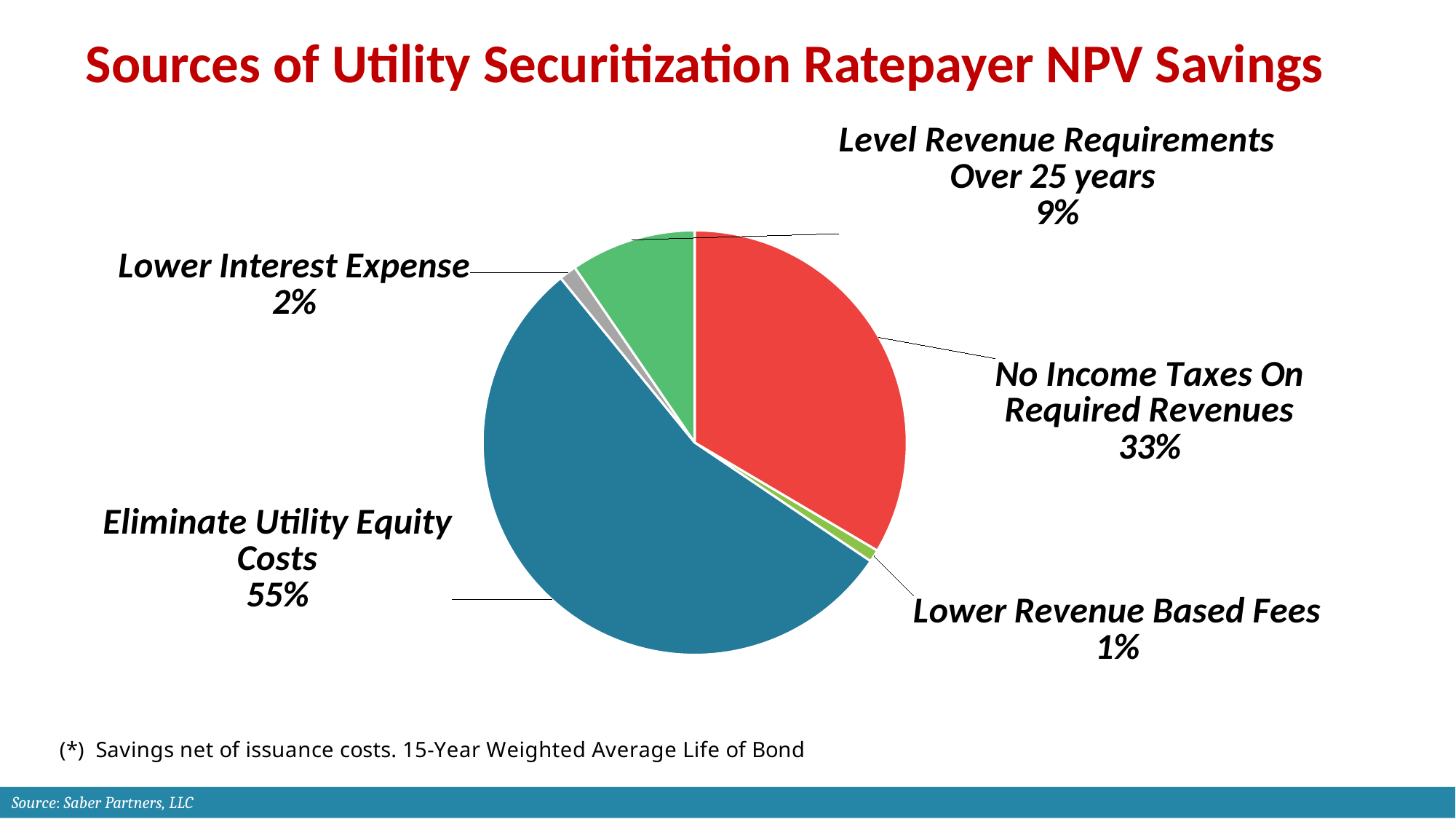
What is the title of the chart? Sources of Utility Securitization Ratepayer NPV Savings What kind of chart is shown on the slide? Pie chart What share of savings comes from No Income Taxes On Required Revenues? 33% What share of savings comes from Level Revenue Requirements Over 25 years? 9% What share of savings comes from Lower Interest Expense? 2% Which is larger: the share for Level Revenue Requirements Over 25 years or the share for Lower Interest Expense? Level Revenue Requirements Over 25 years Which source accounts for the largest share of savings? Eliminate Utility Equity Costs How many slices does the pie chart have? 5 What is the difference in percentage points between Eliminate Utility Equity Costs and No Income Taxes On Required Revenues? 22 percentage points Which source accounts for the smallest share of savings? Lower Revenue Based Fees